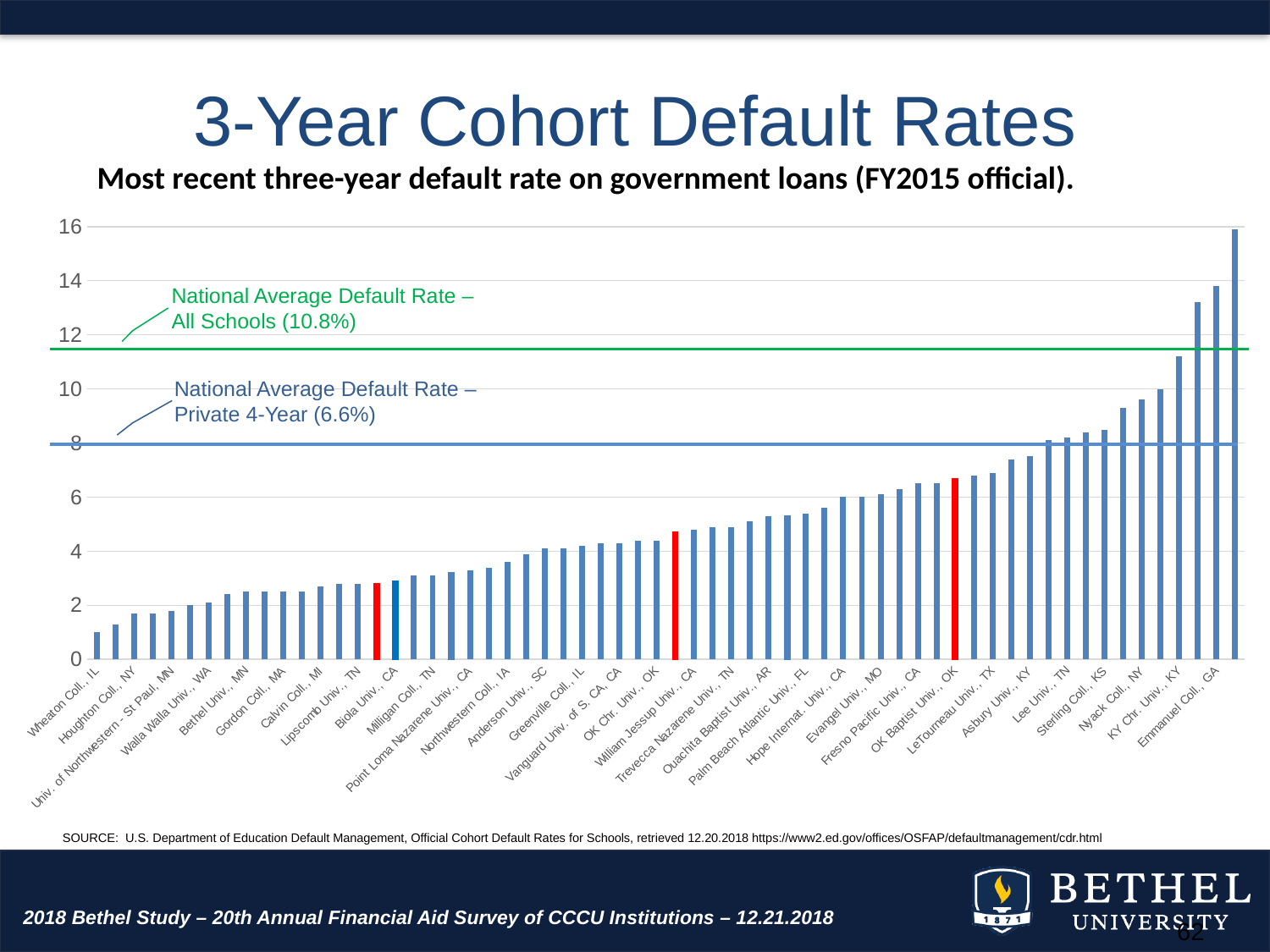
What is the title of the chart on the slide? 3-Year Cohort Default Rates Which has a higher default rate, Wheaton Coll., IL or Emmanuel Coll., GA? Emmanuel Coll., GA Is the value for Nyack Coll., NY greater or less than 10? less What kind of chart is shown on the slide? bar chart What is the National Average Default Rate for All Schools shown on the chart? 10.8% Is the value for Bethel Univ., MN greater or less than 4? less What is the National Average Default Rate for Private 4-Year schools shown on the chart? 6.6% Do the default rates rise or fall moving from left to right along the x axis? rise Is the value for Wheaton Coll., IL greater or less than 2? less Which school has the lowest default rate on the chart? Wheaton Coll., IL